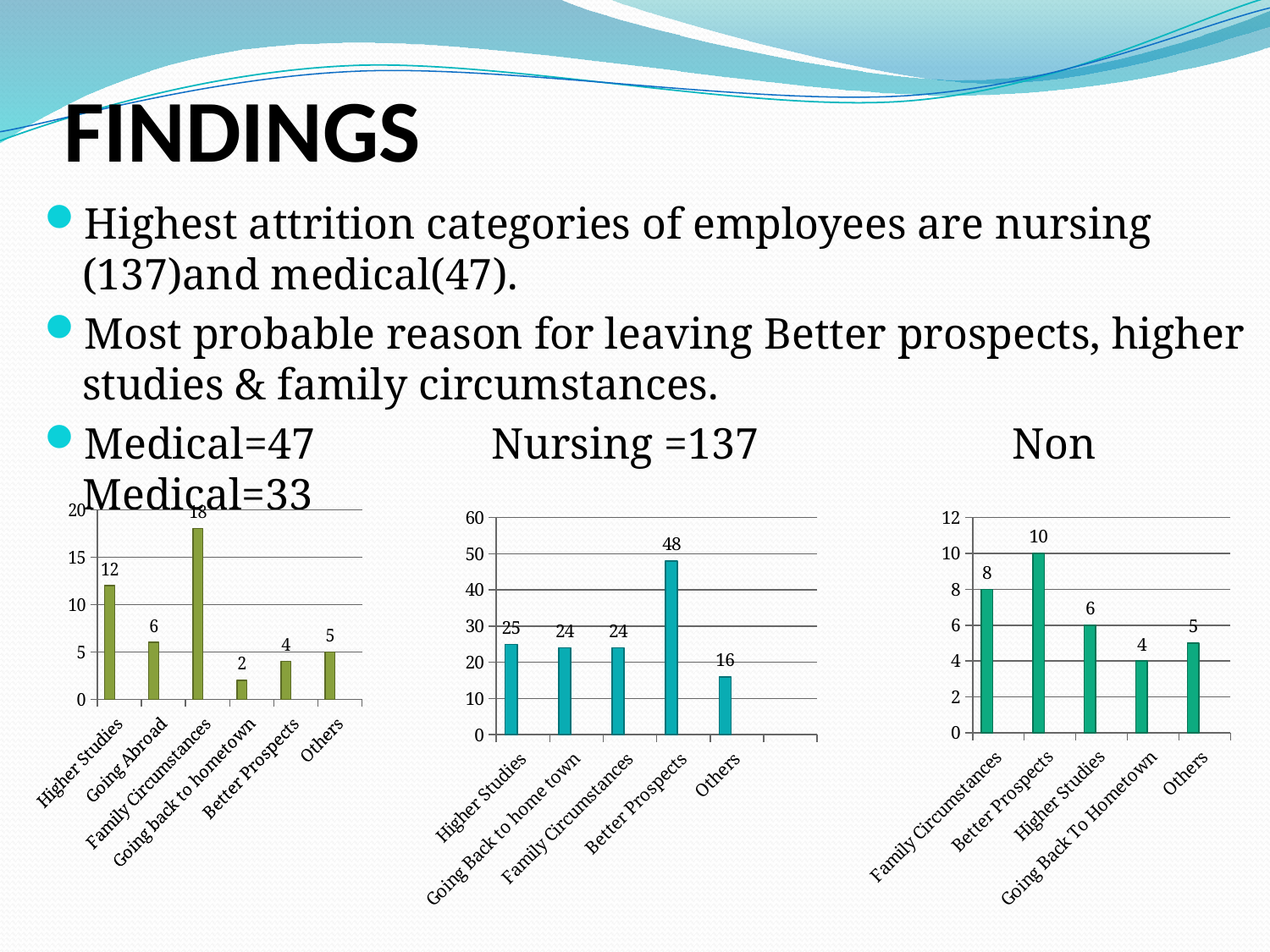
In the middle (Nursing) chart, which category has the highest value? Better Prospects What type of chart is the middle (Nursing) chart? Bar chart In the middle (Nursing) chart, what is the value for Others? 16 In the left (Medical) chart, what is the value for Family Circumstances? 18 In the middle (Nursing) chart, how many categories are shown? 5 In the left (Medical) chart, what is the difference between Higher Studies and Going Abroad? 6 In the right (Non Medical) chart, what is the value for Better Prospects? 10 In the left (Medical) chart, which category has the lowest value? Going back to hometown In the middle (Nursing) chart, what is the value for Better Prospects? 48 In the left (Medical) chart, how many categories are shown? 6 In the right (Non Medical) chart, which is larger, Family Circumstances or Higher Studies? Family Circumstances In the right (Non Medical) chart, which category has the lowest value? Going Back To Hometown